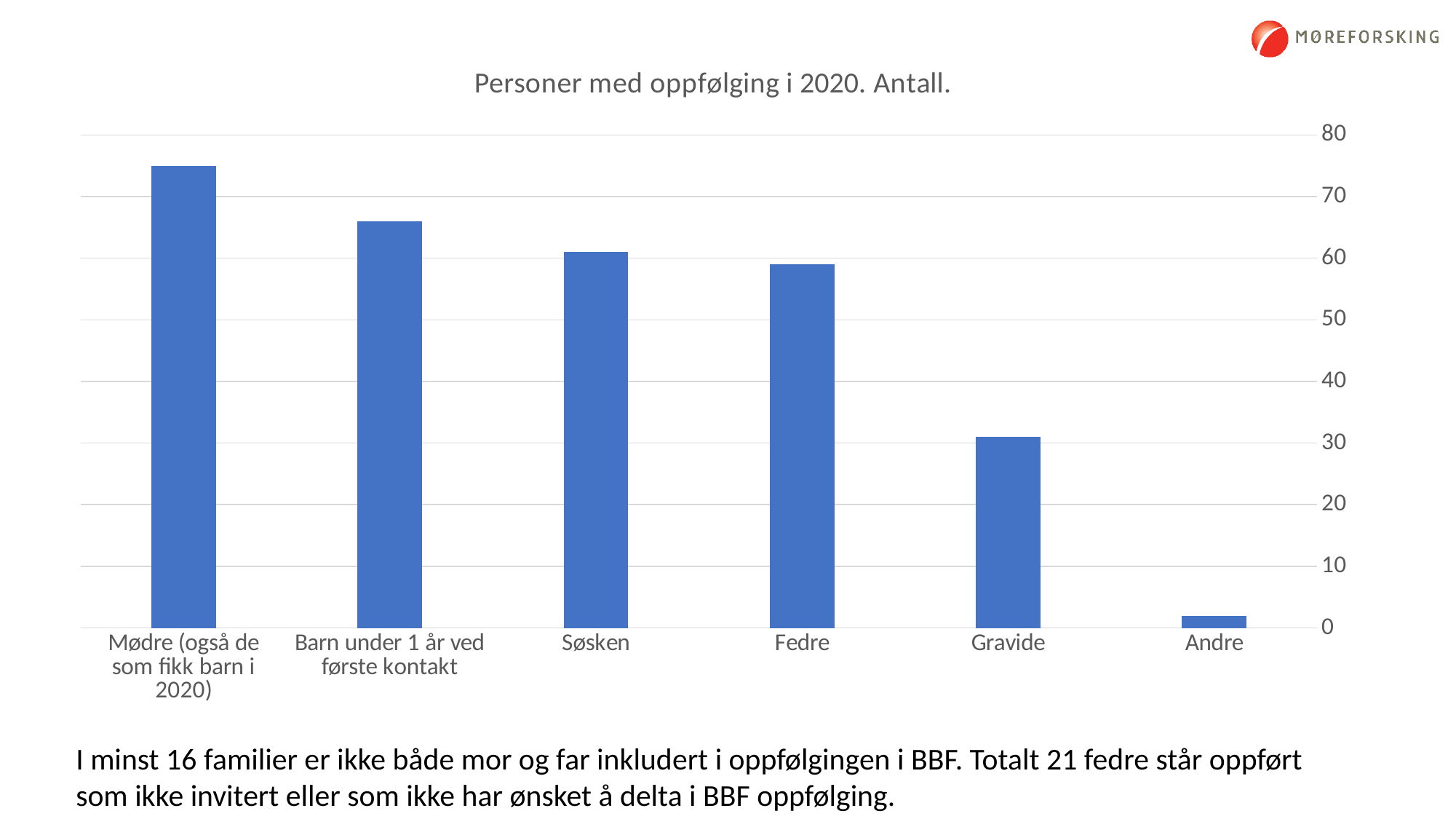
How many categories are shown on the x axis of the chart? 6 What kind of chart is shown on the slide? bar chart Which category has the highest value? Mødre (også de som fikk barn i 2020) Is the value for Mødre (også de som fikk barn i 2020) greater or less than 70? greater What is the title of the chart? Personer med oppfølging i 2020. Antall. Which is larger, the value for Barn under 1 år ved første kontakt or the value for Søsken? Barn under 1 år ved første kontakt Is the value for Barn under 1 år ved første kontakt greater or less than 70? less Is the value for Andre greater or less than 10? less Do the values rise or fall from left to right along the x axis? fall Which category has the lowest value? Andre